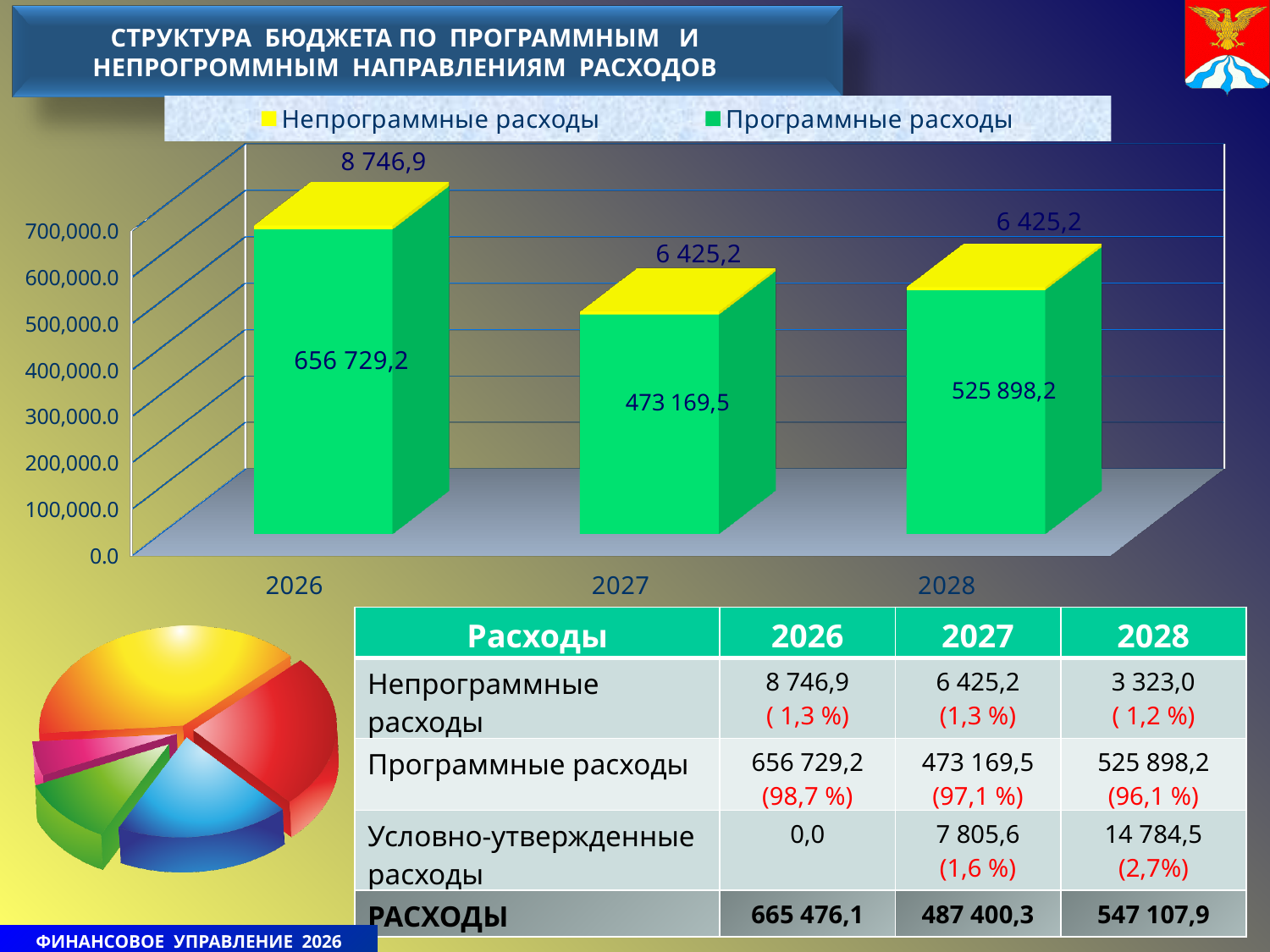
What is the value of Непрограммные расходы for 2027? 6 425,2 What is the value of Программные расходы for 2028? 525 898,2 What is the value of Непрограммные расходы for 2026? 8 746,9 What is the difference between Программные расходы in 2026 and 2027? 183 559,7 What is the total of the stacked bar for 2026? 665 476,1 Which is larger: Программные расходы in 2027 or in 2028? 2028 What is the value of Программные расходы for 2026? 656 729,2 Is the value for Программные расходы in 2027 greater or less than 500,000.0? less Which year has the highest value for Программные расходы? 2026 How many years are shown on the x axis of the bar chart? 3 Which year has the lowest value for Программные расходы? 2027 How many series does the legend of the bar chart list? 2